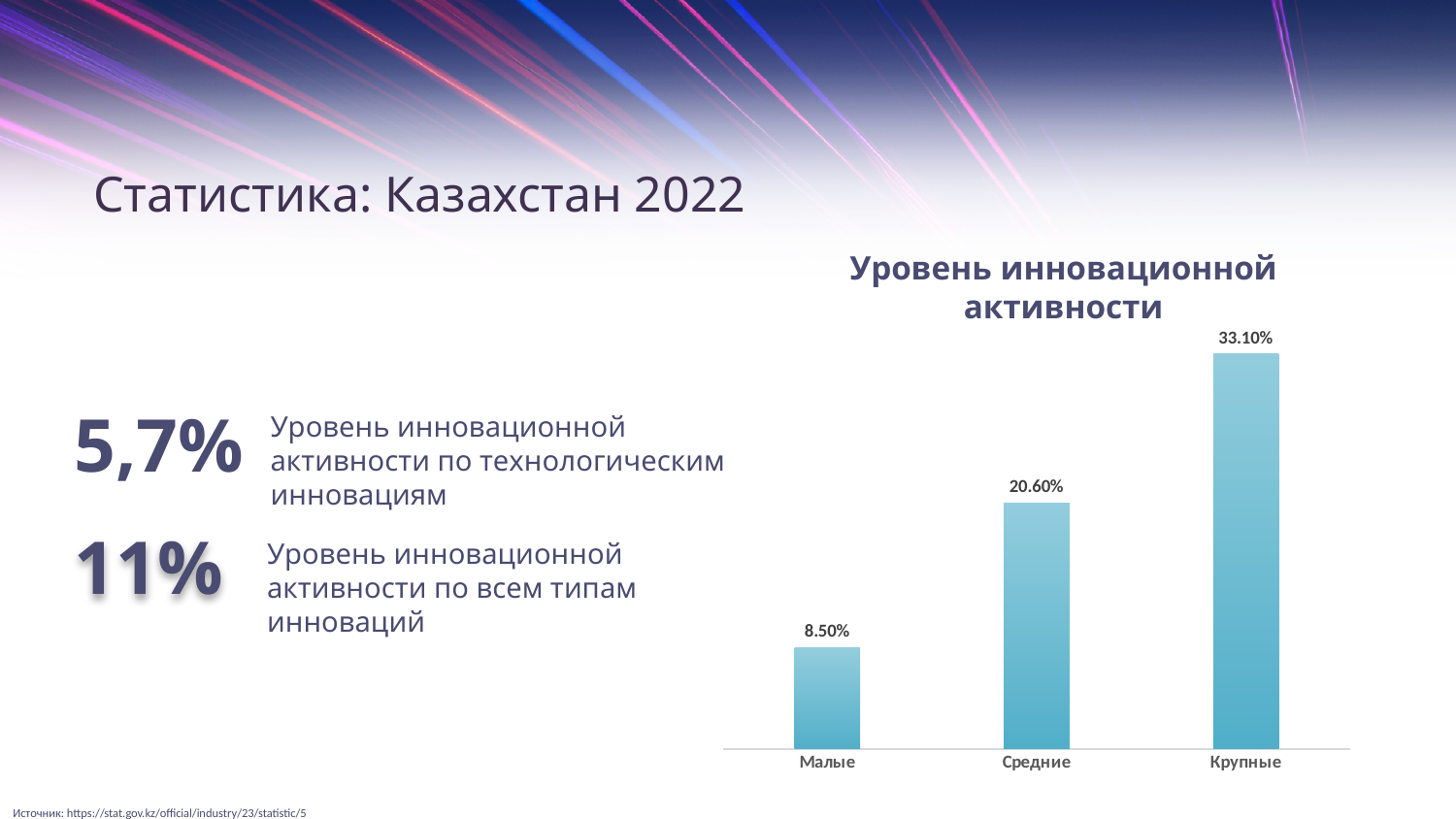
Which category has the lowest value in the chart? Малые What is the title of the chart? Уровень инновационной активности What is the value for Средние in the chart? 20.60% What is the difference between the values for Средние and Малые? 12.10% What is the difference between the values for Крупные and Средние? 12.50% What is the value for Малые in the chart? 8.50% How many categories are shown in the chart? 3 What kind of chart is shown on the slide? Bar chart Which category has the highest value in the chart? Крупные Which is larger, the value for Средние or the value for Малые? Средние What is the value for Крупные in the chart? 33.10% What is the difference between the values for Крупные and Малые? 24.60%